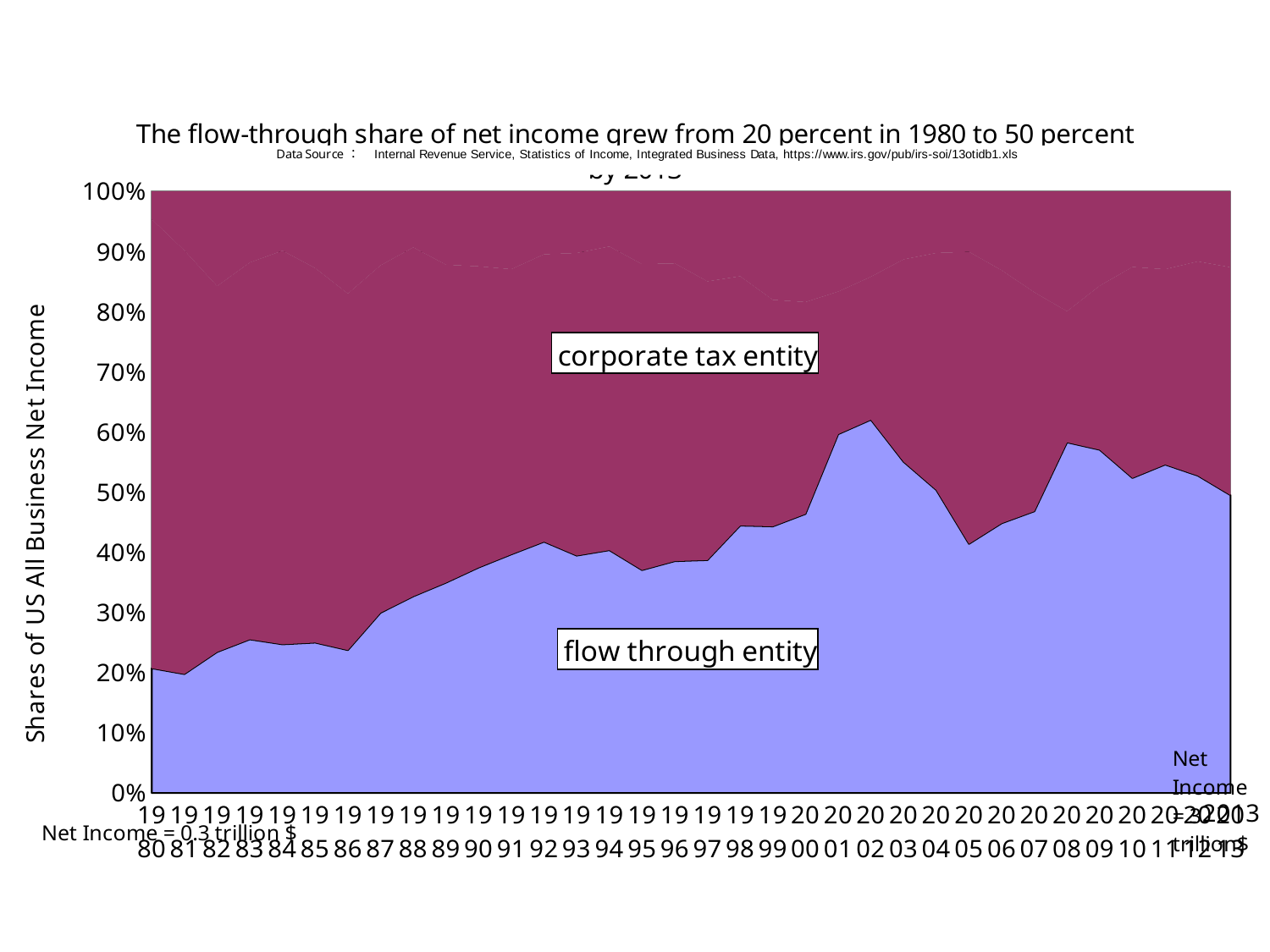
According to the chart title, what was the flow-through share of net income in 1980? 20 percent What is the label on the vertical axis of the chart? Shares of US All Business Net Income Overall, does the flow through entity share rise or fall from 1980 to 2013? rise Is the corporate tax entity share in 1980 greater or less than 70%? greater Is the flow through entity share in 1986 greater or less than 30%? less According to the chart title, what was the flow-through share of net income by 2013? 50 percent In which year does the flow through entity share reach its highest point? 2002 Is the flow through entity share in 2008 greater or less than 50%? greater How many years are shown along the x axis of the chart? 34 What kind of chart is shown on the slide? stacked area chart How many series are plotted in the chart? 3